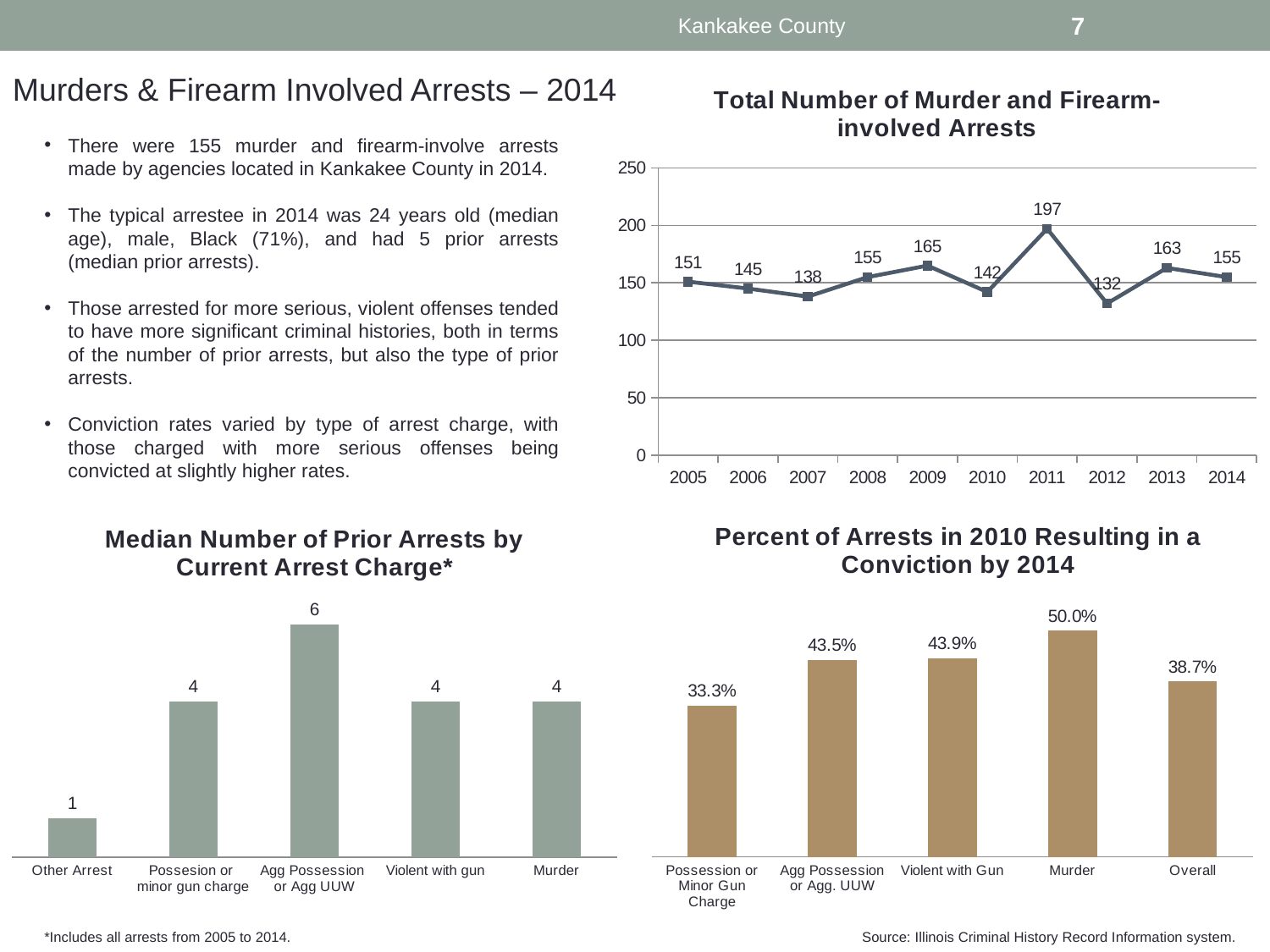
In the 'Total Number of Murder and Firearm-involved Arrests' chart, which year had the lowest number of arrests? 2012 In the 'Total Number of Murder and Firearm-involved Arrests' chart, how many years are plotted? 10 In the 'Median Number of Prior Arrests by Current Arrest Charge' chart, what is the value for Agg Possession or Agg UUW? 6 In the 'Percent of Arrests in 2010 Resulting in a Conviction by 2014' chart, what is the value for Murder? 50.0% In the 'Percent of Arrests in 2010 Resulting in a Conviction by 2014' chart, what is the difference between Murder and Possession or Minor Gun Charge? 16.7% In the 'Median Number of Prior Arrests by Current Arrest Charge' chart, which category has the lowest value? Other Arrest In the 'Total Number of Murder and Firearm-involved Arrests' chart, what is the difference between the 2011 and 2012 values? 65 In the 'Median Number of Prior Arrests by Current Arrest Charge' chart, how many categories are shown? 5 In the 'Total Number of Murder and Firearm-involved Arrests' chart, did the value rise or fall from 2013 to 2014? Fall In the 'Percent of Arrests in 2010 Resulting in a Conviction by 2014' chart, which is larger: Agg Possession or Agg. UUW or Overall? Agg Possession or Agg. UUW What type of chart is the 'Total Number of Murder and Firearm-involved Arrests' chart? Line chart In the 'Total Number of Murder and Firearm-involved Arrests' chart, what was the value for 2011? 197